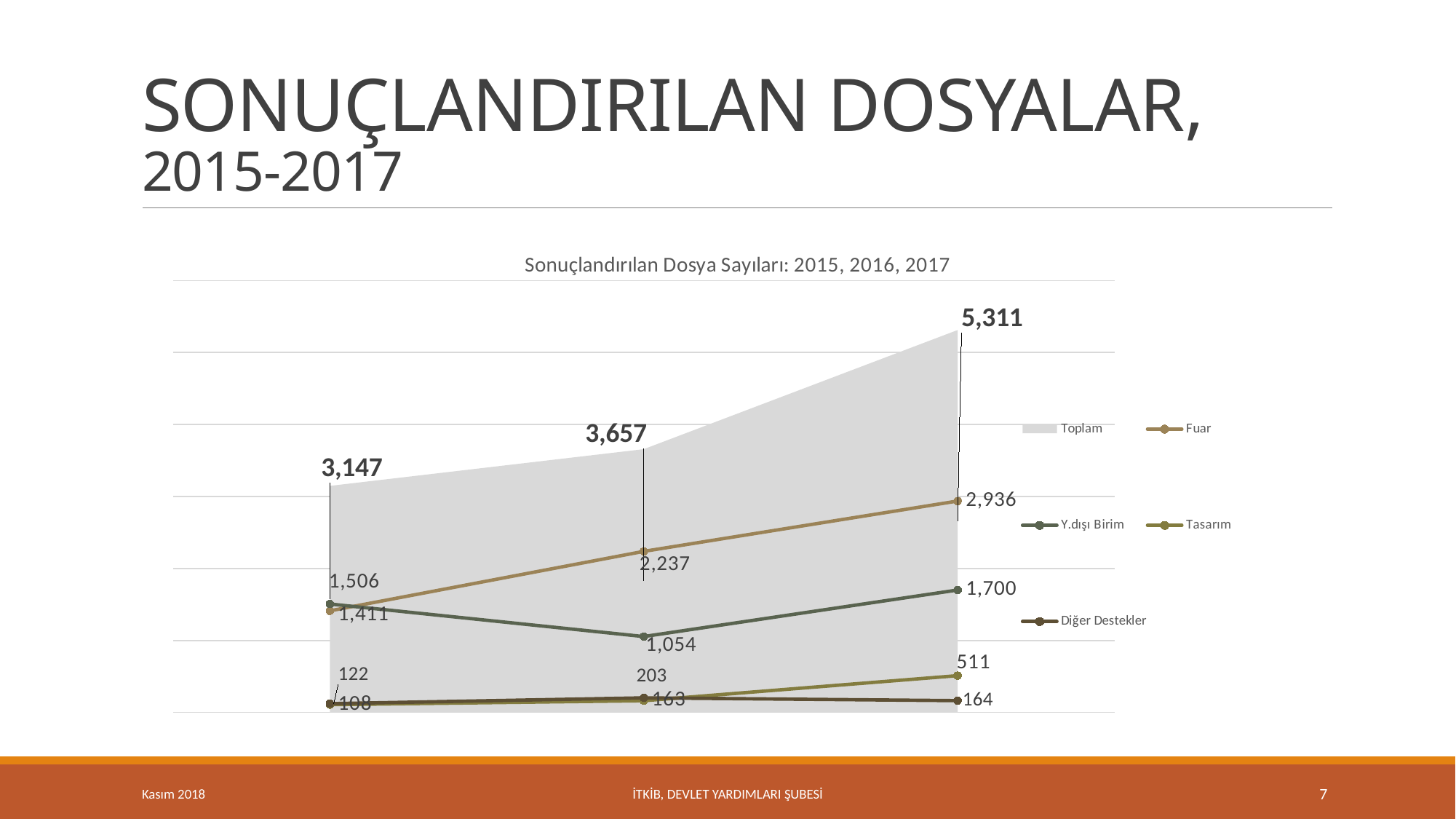
What is the Diğer Destekler value for 2015 (the leftmost point)? 122 What is the Tasarım value for 2017 (the rightmost point)? 511 What is the Fuar value for 2016 (the middle point)? 2,237 What is the Toplam value for 2017 (the rightmost point)? 5,311 In which year is the Y.dışı Birim value lowest? 2016 At the 2015 (leftmost) point, which is larger: Fuar or Y.dışı Birim? Y.dışı Birim What is the Y.dışı Birim value for 2016 (the middle point)? 1,054 Does the Fuar series rise or fall from 2015 to 2017? rises In which year is the Fuar value highest? 2017 By how much did the Toplam value increase from 2015 (3,147) to 2017 (5,311)? 2,164 How many series does the legend list? 5 What is the title of the chart? Sonuçlandırılan Dosya Sayıları: 2015, 2016, 2017